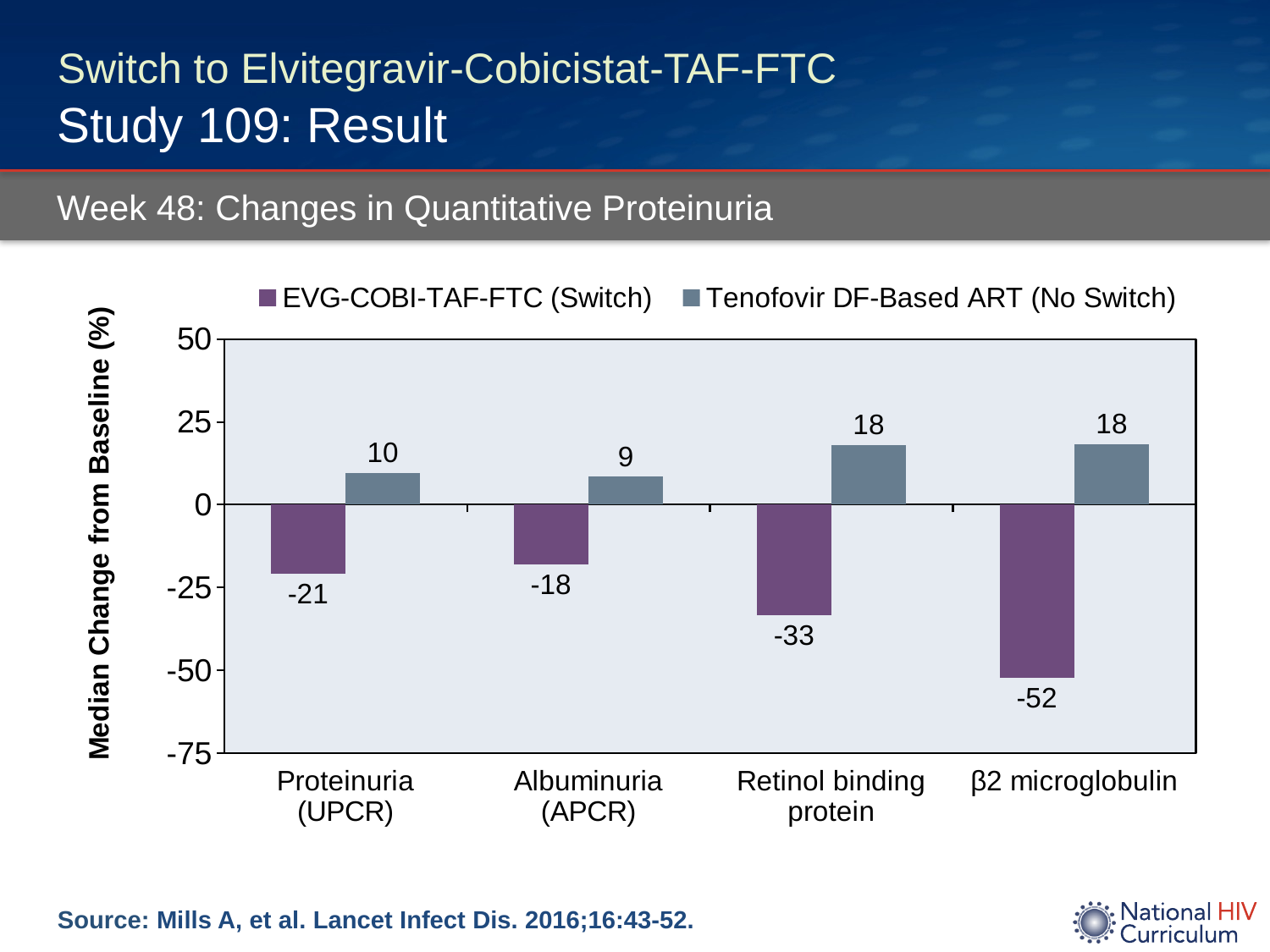
Which is larger for Proteinuria (UPCR): the EVG-COBI-TAF-FTC (Switch) value or the Tenofovir DF-Based ART (No Switch) value? Tenofovir DF-Based ART (No Switch) What is the median change from baseline for Tenofovir DF-Based ART (No Switch) in Albuminuria (APCR)? 9 How many categories are shown on the x axis? 4 What kind of chart is shown on the slide? Bar chart Which category has the lowest value for EVG-COBI-TAF-FTC (Switch)? β2 microglobulin What is the median change from baseline for Tenofovir DF-Based ART (No Switch) in Retinol binding protein? 18 What is the median change from baseline for EVG-COBI-TAF-FTC (Switch) in Proteinuria (UPCR)? -21 How many series does the legend list? 2 What is the label of the y axis? Median Change from Baseline (%) Which category has the lowest value for Tenofovir DF-Based ART (No Switch)? Albuminuria (APCR) What is the median change from baseline for EVG-COBI-TAF-FTC (Switch) in β2 microglobulin? -52 What is the difference between the Tenofovir DF-Based ART (No Switch) and EVG-COBI-TAF-FTC (Switch) values for Retinol binding protein? 51